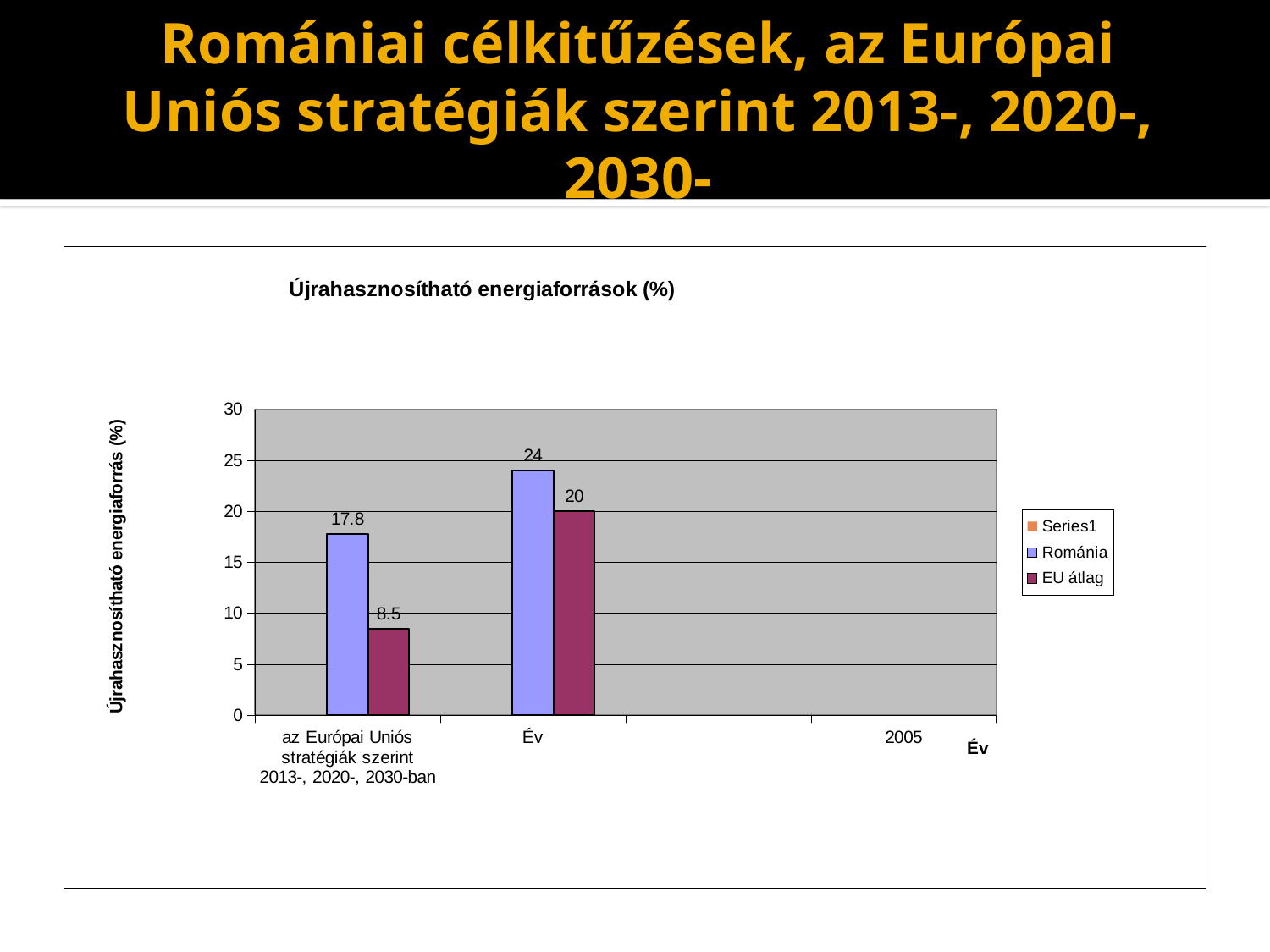
Which bar has the lowest value on the chart? EU átlag in the 'az Európai Uniós stratégiák szerint 2013-, 2020-, 2030-ban' category (8.5) What is the difference between the Románia and EU átlag values in the 'Év' category? 4 What is the difference between the Románia and EU átlag values in the 'az Európai Uniós stratégiák szerint 2013-, 2020-, 2030-ban' category? 9.3 What is the value for EU átlag in the category labelled 'Év'? 20 What is the title of the chart? Újrahasznosítható energiaforrások (%) What is the value for Románia in the category labelled 'Év'? 24 Which is larger in the 'Év' category, Románia or EU átlag? Románia How many entries does the legend list? 3 Which bar has the highest value on the chart? Románia in the 'Év' category (24) What kind of chart is shown on the slide? Bar chart What is the value for Románia in the category 'az Európai Uniós stratégiák szerint 2013-, 2020-, 2030-ban'? 17.8 What is the value for EU átlag in the category 'az Európai Uniós stratégiák szerint 2013-, 2020-, 2030-ban'? 8.5